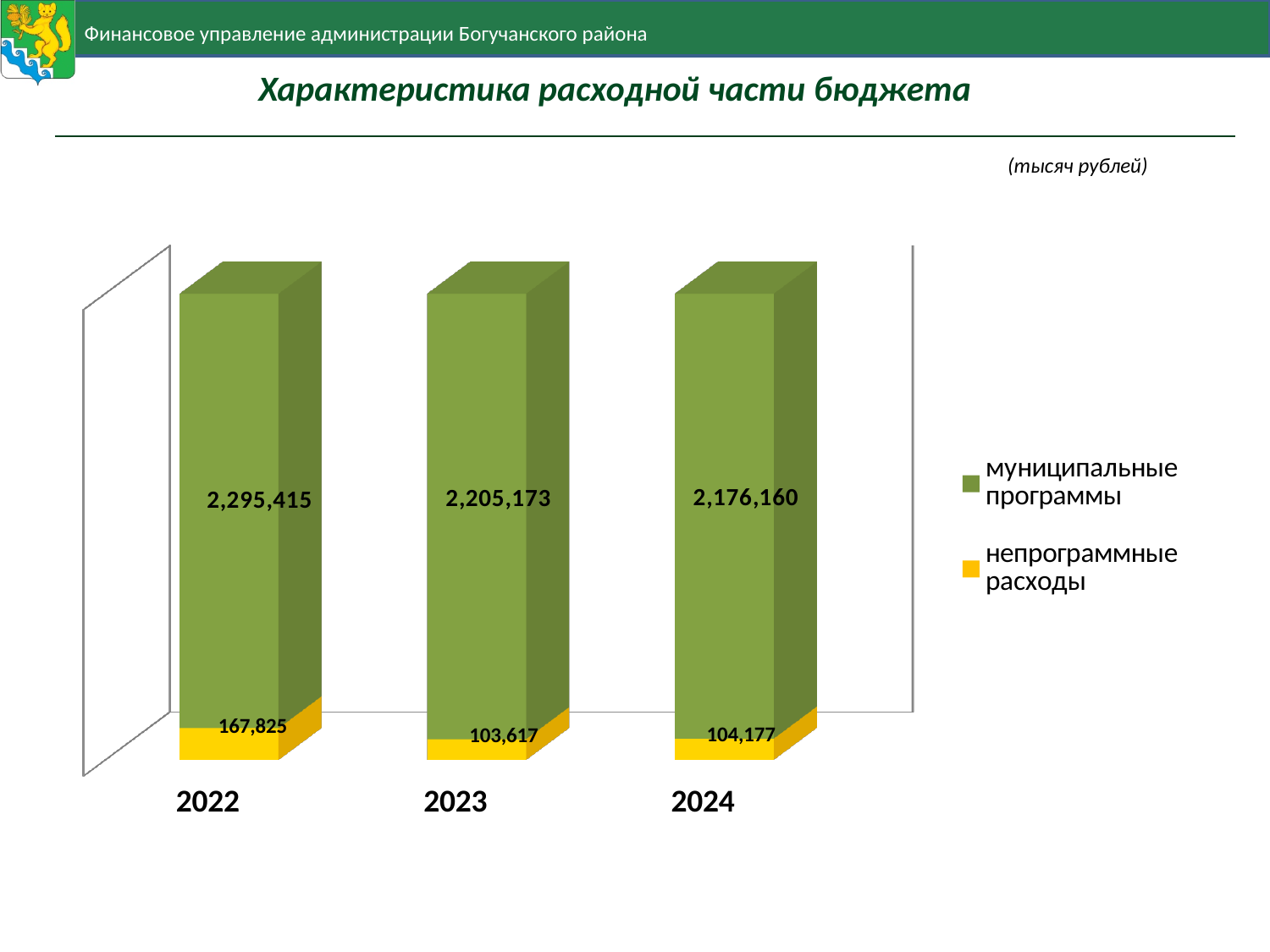
In which year is the value for непрограммные расходы the lowest? 2023 How many series does the legend list? 2 Which is larger: муниципальные программы in 2023 or in 2024? 2023 What is the value for муниципальные программы in 2022? 2,295,415 What is the value for муниципальные программы in 2024? 2,176,160 What is the total of the stacked bar for 2022? 2,463,240 What is the difference between the муниципальные программы values for 2022 and 2023? 90,242 In which year is the value for муниципальные программы the highest? 2022 Do the values for муниципальные программы rise or fall from 2022 to 2024? fall What is the value for непрограммные расходы in 2023? 103,617 What is the value for непрограммные расходы in 2024? 104,177 What is the difference between the непрограммные расходы values for 2022 and 2023? 64,208